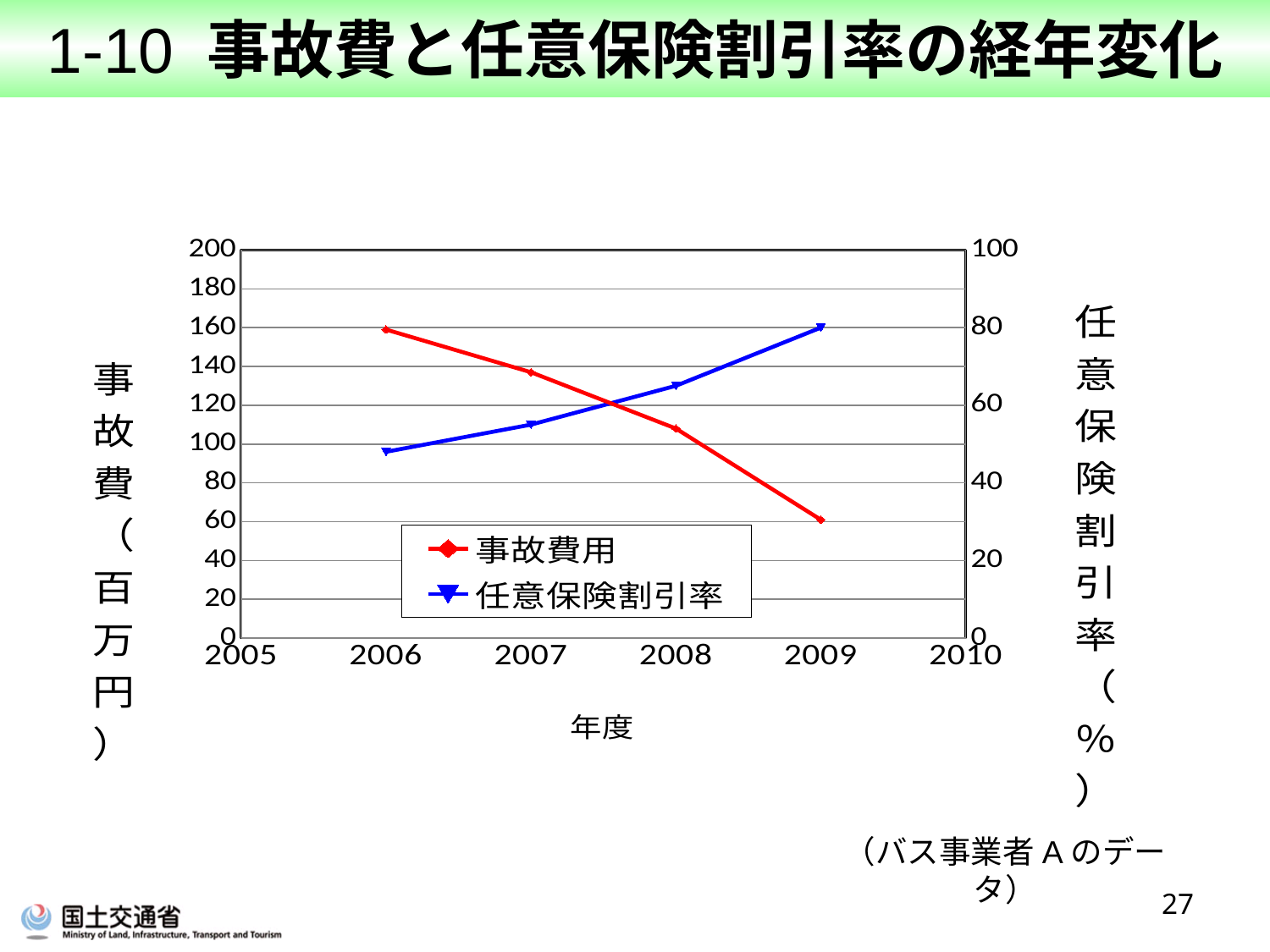
What kind of chart is shown on the slide? line chart In which year is 事故費用 highest? 2006 Does the 任意保険割引率 series rise or fall from 2006 to 2009? rise How many series does the legend list? 2 How many data points are plotted for the 事故費用 series? 4 What is the title of the x axis? 年度 Is the value for 事故費用 in 2009 greater or less than 80? less Is the value for 任意保険割引率 in 2006 greater or less than 40? greater Is the value for 事故費用 in 2007 greater or less than 120? greater In which year is 事故費用 lowest? 2009 In which year is 任意保険割引率 highest? 2009 Does the 事故費用 series rise or fall from 2006 to 2009? fall